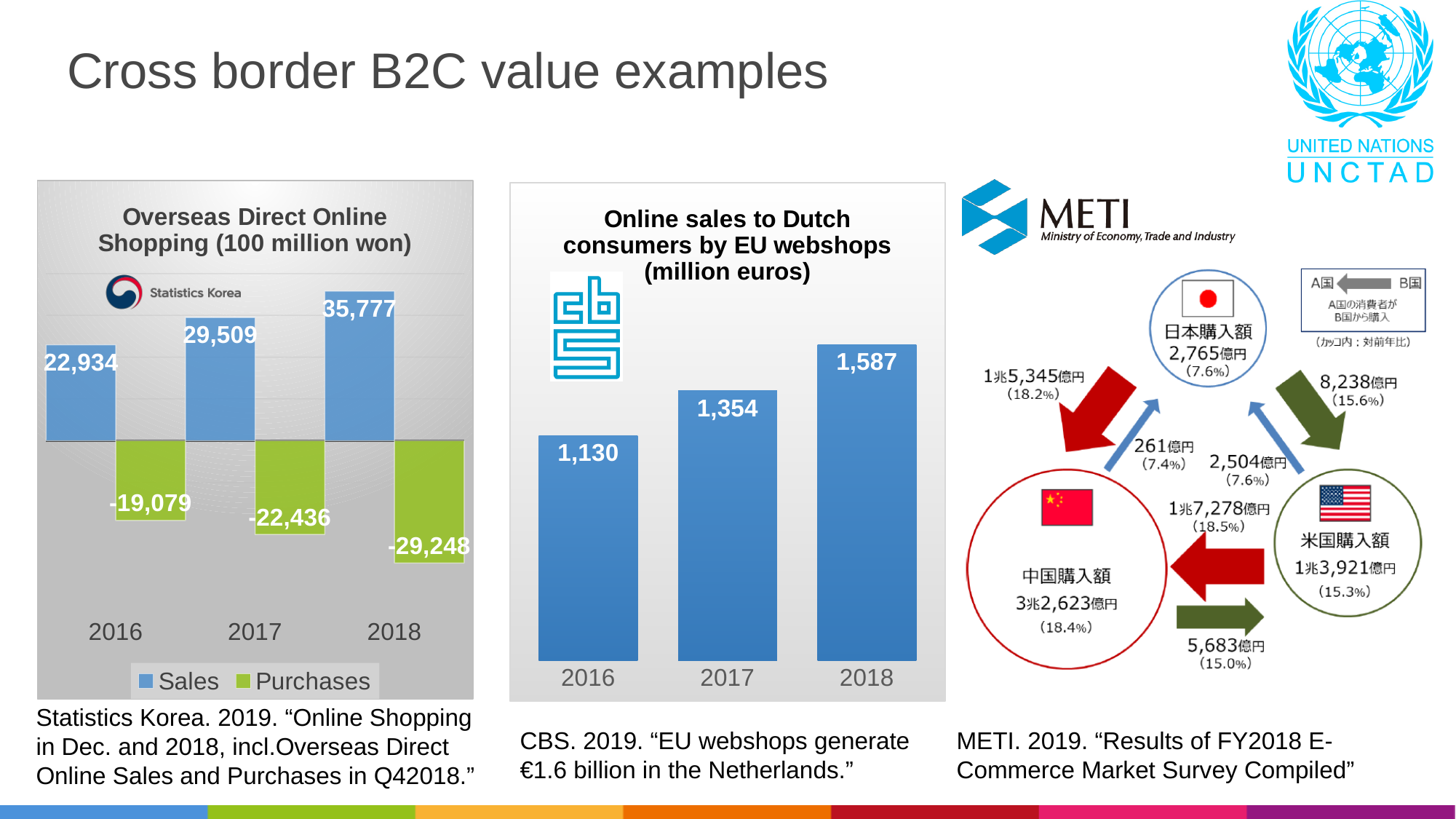
In the 'Overseas Direct Online Shopping' chart, what is the difference between the Sales values for 2018 and 2016? 12,843 In the 'Overseas Direct Online Shopping' chart, what colour are the Purchases bars? green In the 'Online sales to Dutch consumers by EU webshops' chart, how many years are shown on the x axis? 3 What kind of chart is the 'Online sales to Dutch consumers by EU webshops' chart? bar chart In the 'Online sales to Dutch consumers by EU webshops' chart, which year has the lowest value? 2016 In the 'Overseas Direct Online Shopping' chart, what is the Sales value for 2018? 35,777 In the 'Online sales to Dutch consumers by EU webshops' chart, what is the difference between the 2018 and 2016 values? 457 In the 'Online sales to Dutch consumers by EU webshops' chart, what is the value for 2017? 1,354 In the 'Overseas Direct Online Shopping' chart, do the Sales values rise or fall from 2016 to 2018? rise In the 'Overseas Direct Online Shopping' chart, what is the Purchases value for 2017? -22,436 In the 'Overseas Direct Online Shopping' chart, how many series does the legend list? 2 In the 'Overseas Direct Online Shopping' chart, which year has the highest Sales value? 2018